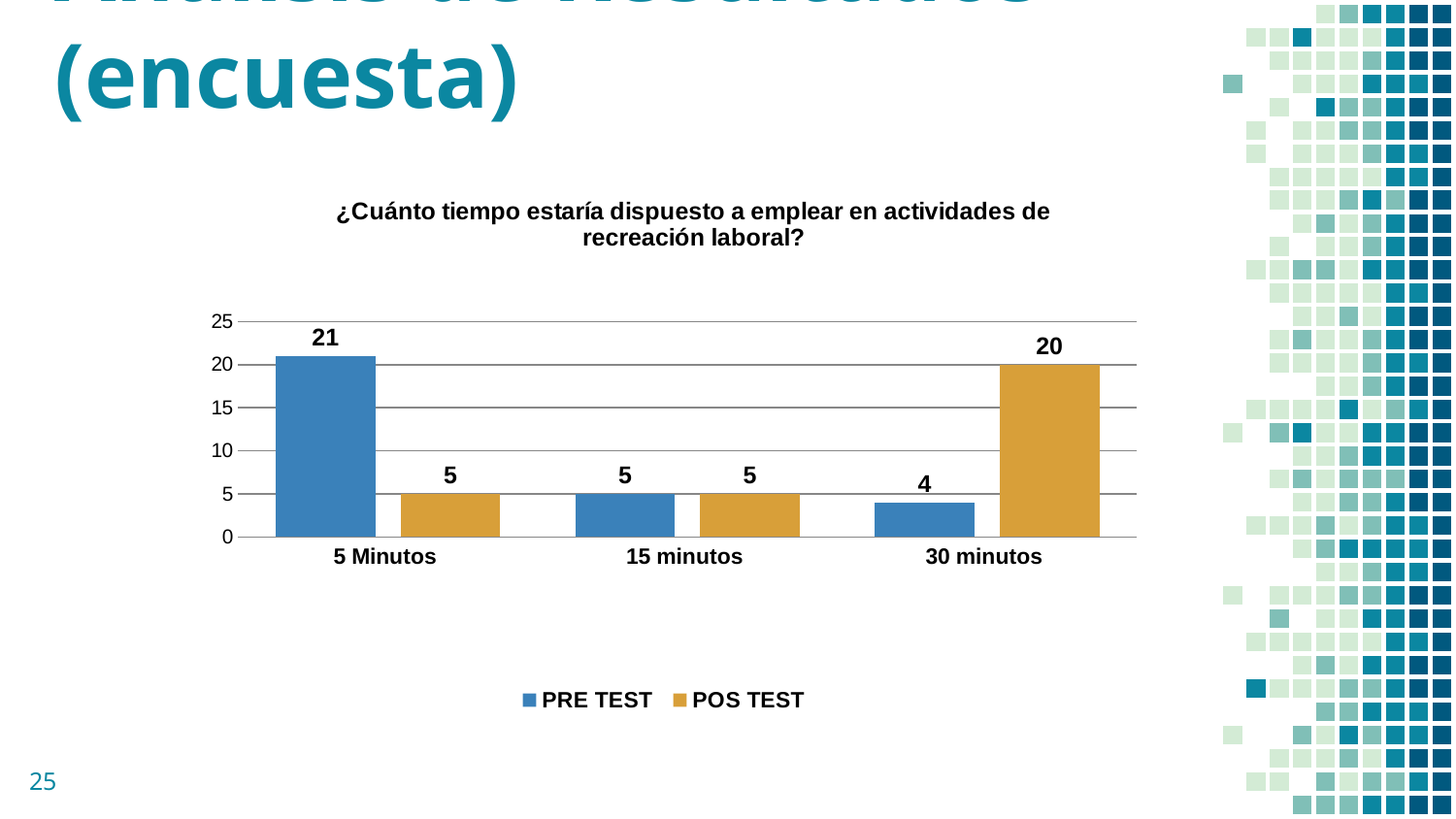
How many series does the legend list? 2 Which category has the lowest PRE TEST value? 30 minutos What is the difference between the PRE TEST and POS TEST values for 5 Minutos? 16 Which is larger for 30 minutos, the PRE TEST value or the POS TEST value? POS TEST What is the PRE TEST value for 30 minutos? 4 What kind of chart is shown on the slide? Bar chart What is the PRE TEST value for 5 Minutos? 21 Which category has the highest PRE TEST value? 5 Minutos What is the POS TEST value for 30 minutos? 20 What colour are the POS TEST bars? Orange How many categories are shown on the x axis? 3 What is the POS TEST value for 15 minutos? 5